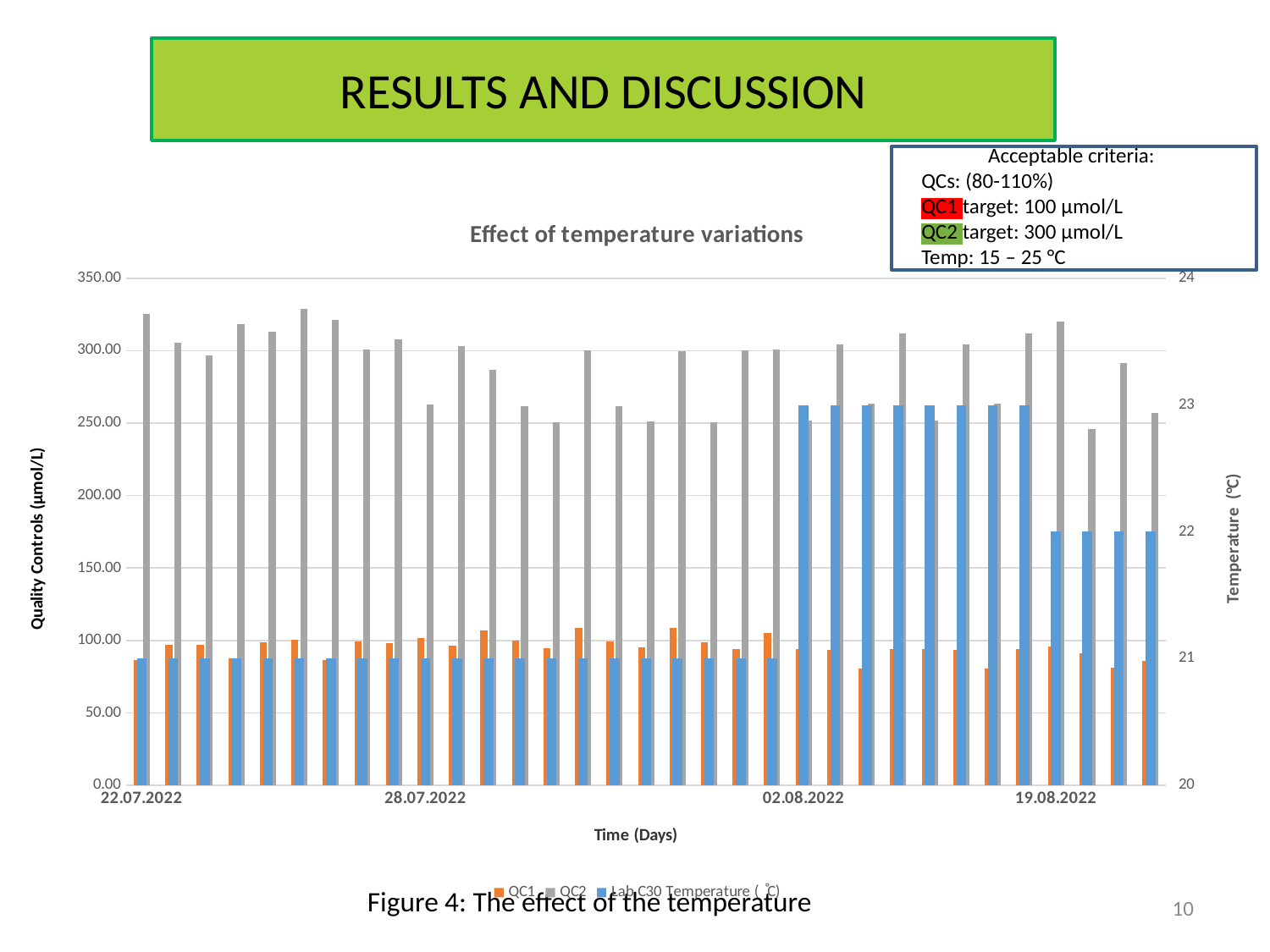
How many dates are labelled on the x axis of the chart? 4 What kind of chart is shown on the slide? bar chart Is the Lab C30 Temperature at 02.08.2022 greater or less than 22? greater What is the title of the x axis of the chart? Time (Days) What is the title of the chart? Effect of temperature variations Is the Lab C30 Temperature at 02.08.2022 higher or lower than at 22.07.2022? higher Is the Lab C30 Temperature at 19.08.2022 greater or less than 21? greater Is the QC2 value at 28.07.2022 greater or less than 250? greater At 22.07.2022, which is larger, the QC1 value or the QC2 value? QC2 How many series does the chart legend list? 3